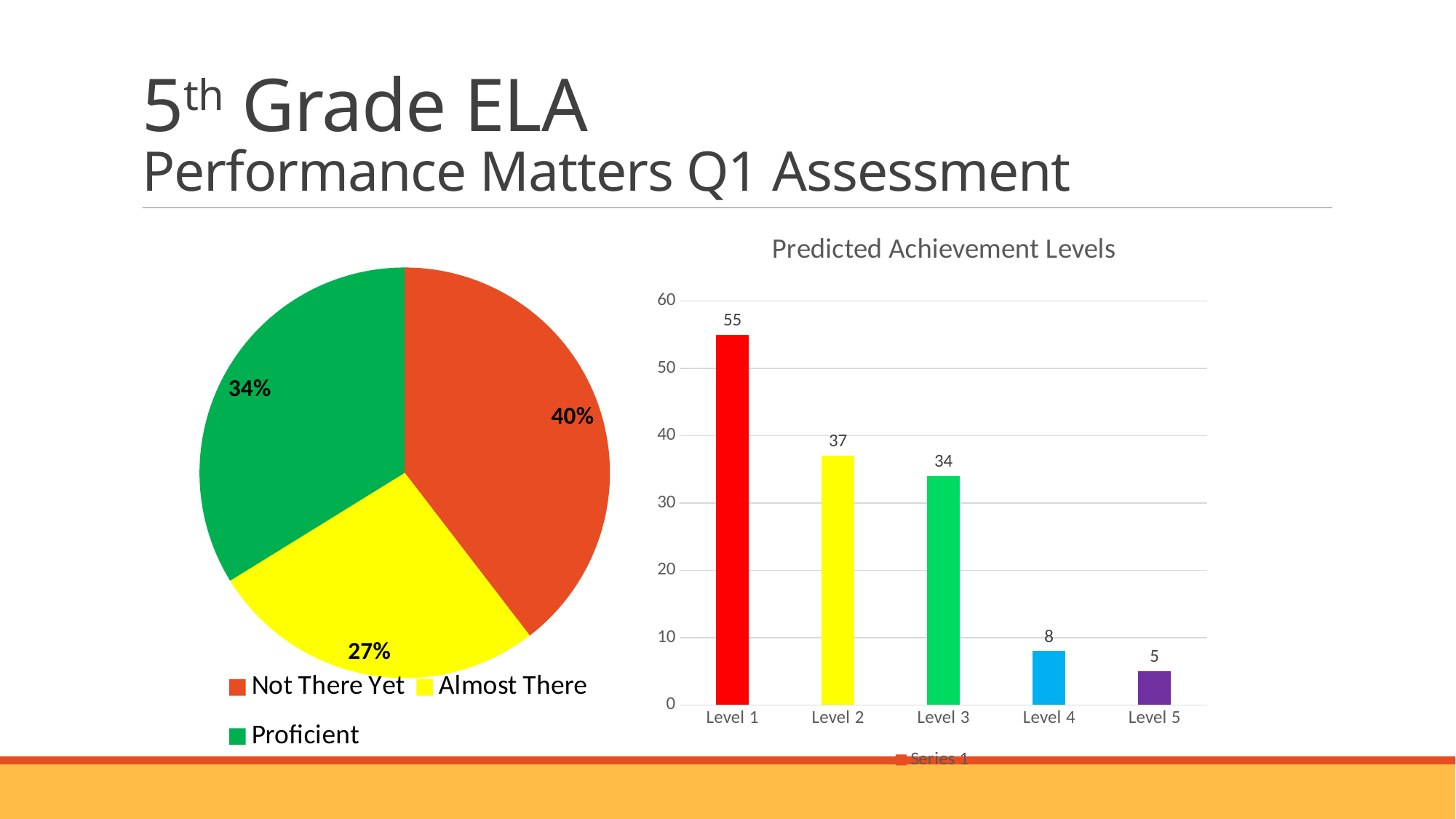
In the pie chart on the left, which category has the smallest slice? Almost There In the pie chart on the left, how many categories does the legend list? 3 In the pie chart on the left, what share does Not There Yet have? 40% In the pie chart on the left, what share does Proficient have? 34% In the pie chart on the left, which category has the largest slice? Not There Yet What kind of chart is the Predicted Achievement Levels chart? Bar chart In the Predicted Achievement Levels chart, what is the value for Level 5? 5 In the Predicted Achievement Levels chart, which is larger, Level 4 or Level 5? Level 4 In the Predicted Achievement Levels chart, how many levels are shown on the x axis? 5 In the Predicted Achievement Levels chart, which level has the highest value? Level 1 In the Predicted Achievement Levels chart, what is the value for Level 2? 37 In the Predicted Achievement Levels chart, what is the difference between Level 1 and Level 3? 21